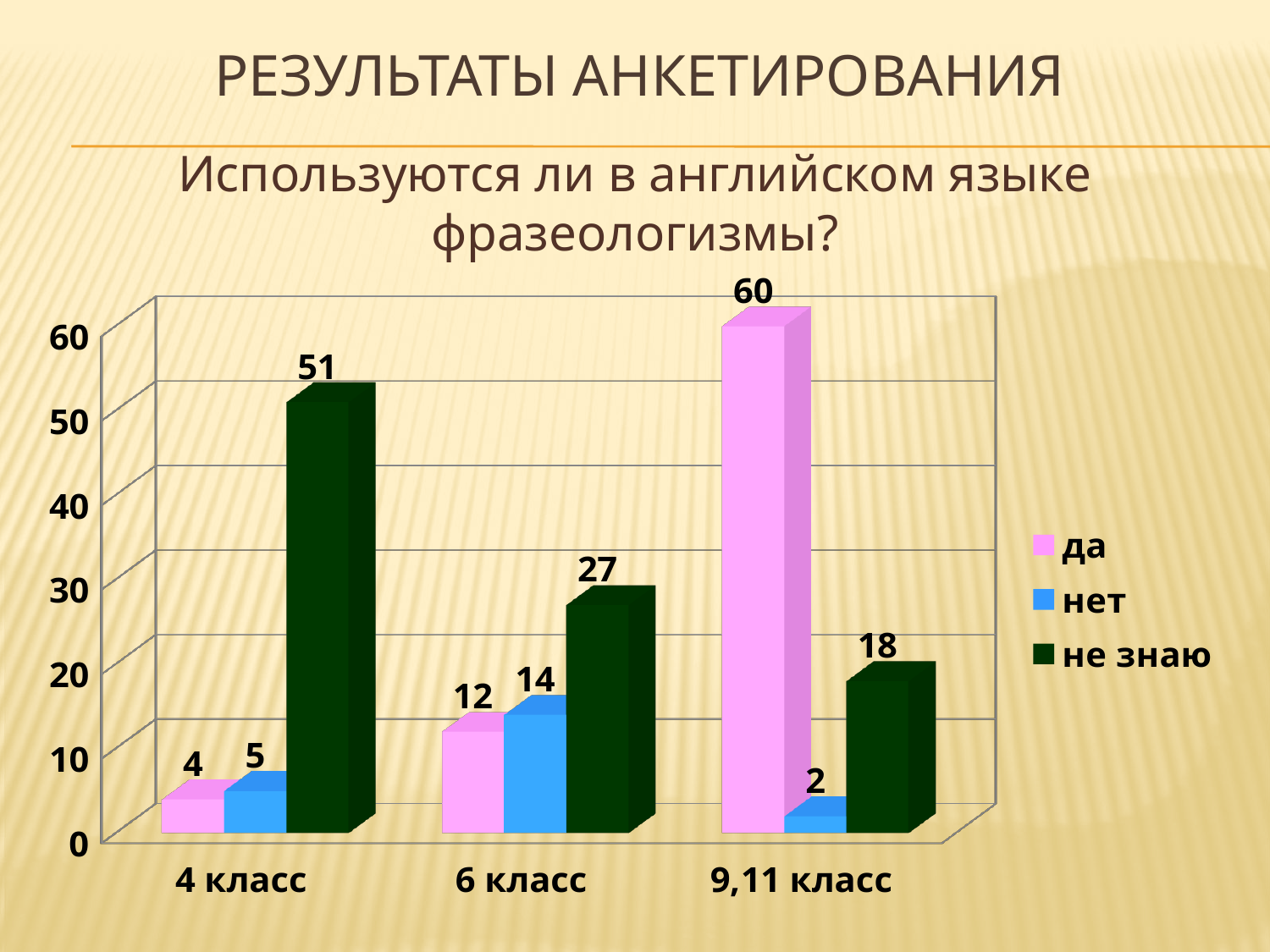
Do the "да" values rise or fall from "4 класс" to "9,11 класс"? rise Which category has the highest value for "не знаю"? 4 класс What is the difference between the "да" values for "9,11 класс" and "6 класс"? 48 Which colour represents the "нет" series in the legend? blue What kind of chart is shown on the slide? bar chart How many categories are shown on the x axis? 3 How many series does the legend list? 3 Which category has the lowest value for "нет"? 9,11 класс What is the value for "не знаю" in the "4 класс" category? 51 What is the value for "да" in the "9,11 класс" category? 60 What is the value for "нет" in the "6 класс" category? 14 Which is larger: "не знаю" for "6 класс" or "не знаю" for "9,11 класс"? 6 класс